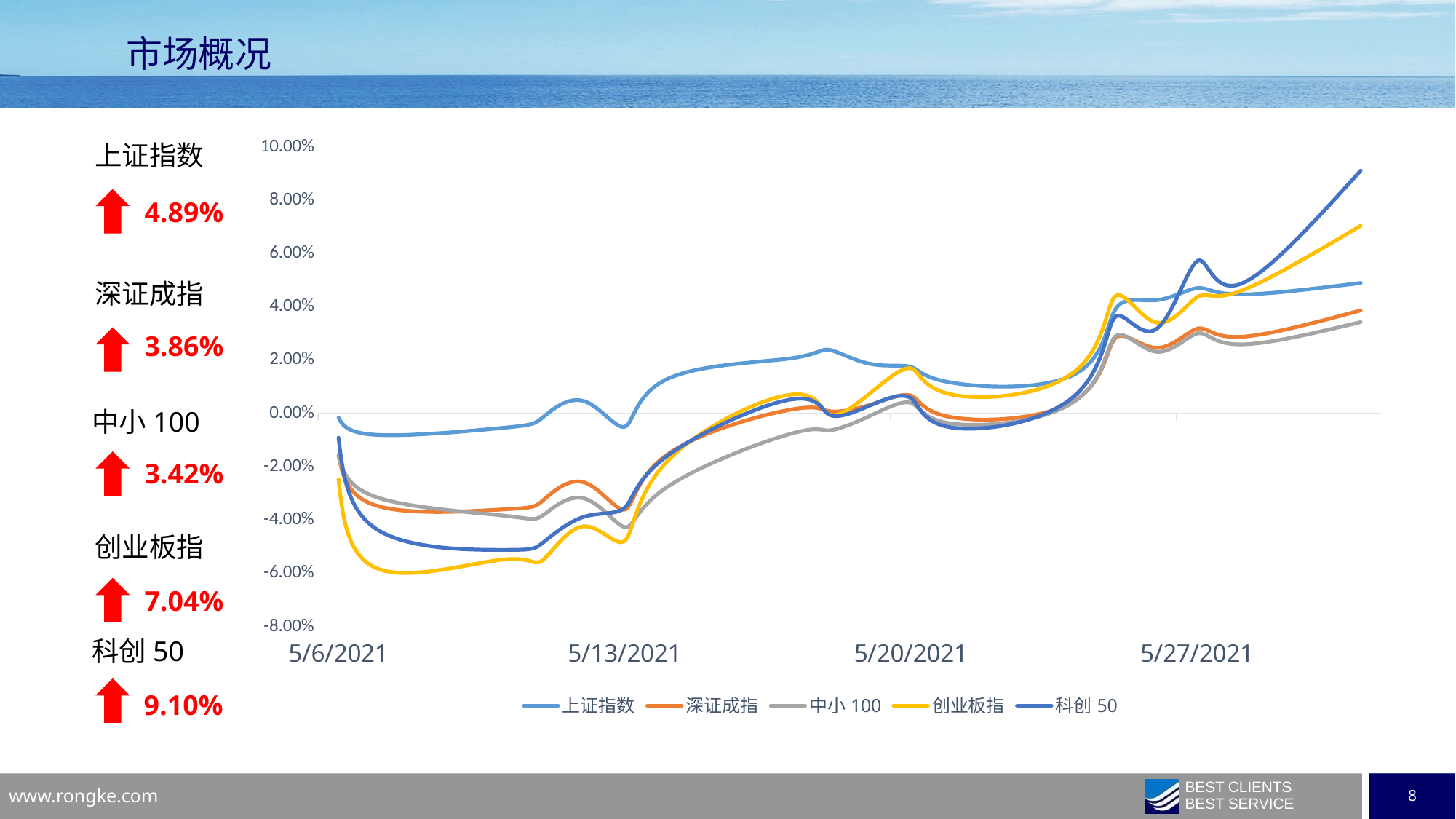
Which series is highest at the right end of the chart (around the end of May 2021)? 科创 50 Is the value of 上证指数 at 5/20/2021 greater or less than 0.00%? greater Is the lowest point of the 创业板指 line greater or less than -4.00%? less What is the title of the slide containing the chart? 市场概况 How many series does the chart legend list? 5 How many date labels are shown on the x axis? 4 Which series is lowest near the start of the chart (around 5/6/2021)? 创业板指 Is the value of 科创 50 at the right end of the chart greater or less than 8.00%? greater Overall, do the lines rise or fall from 5/6/2021 to the end of the chart? rise At the right end of the chart, which is higher: 上证指数 or 深证成指? 上证指数 What percentage change does the slide show for 科创 50? 9.10% What kind of chart is shown on the slide? line chart